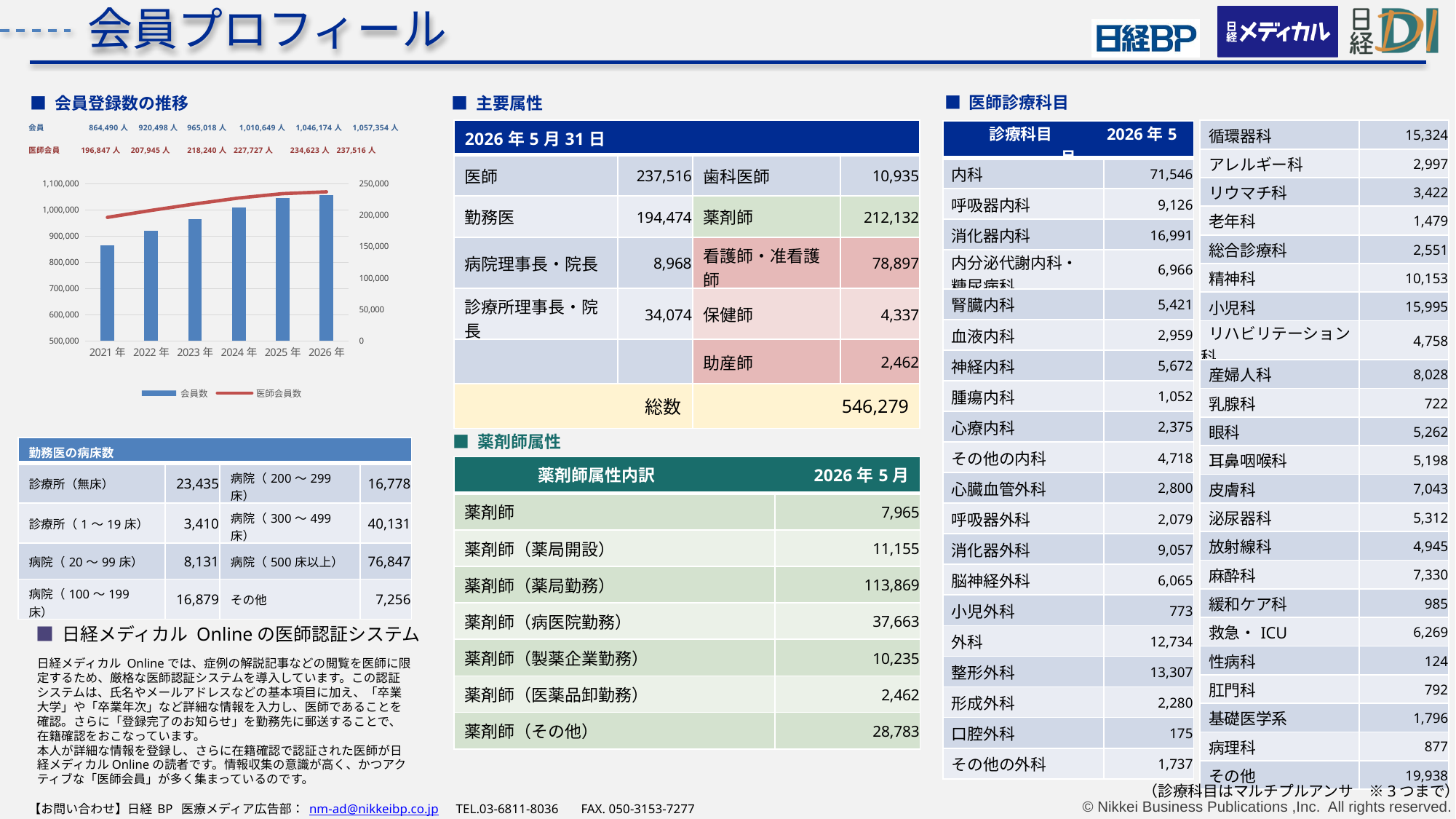
What is the 会員 value for 2021年 in the 会員登録数の推移 chart? 864,490人 In the 会員登録数の推移 chart, is the 会員数 bar for 2021年 greater or less than 900,000? less How many series does the legend of the 会員登録数の推移 chart list? 2 In the 会員登録数の推移 chart, which year has the larger 会員数: 2023年 or 2024年? 2024年 Do the 会員数 bars rise or fall from 2021年 to 2026年 in the 会員登録数の推移 chart? rise Which year has the lowest 会員数 bar in the 会員登録数の推移 chart? 2021年 What kind of chart is the 会員登録数の推移 chart? bar chart with a line Which year has the highest 会員数 bar in the 会員登録数の推移 chart? 2026年 What is the 医師会員 value for 2026年 in the 会員登録数の推移 chart? 237,516人 What are the two legend entries of the 会員登録数の推移 chart? 会員数, 医師会員数 What is the difference between the 会員 values for 2026年 and 2021年 in the 会員登録数の推移 chart? 192,864人 How many years are shown on the x axis of the 会員登録数の推移 chart? 6